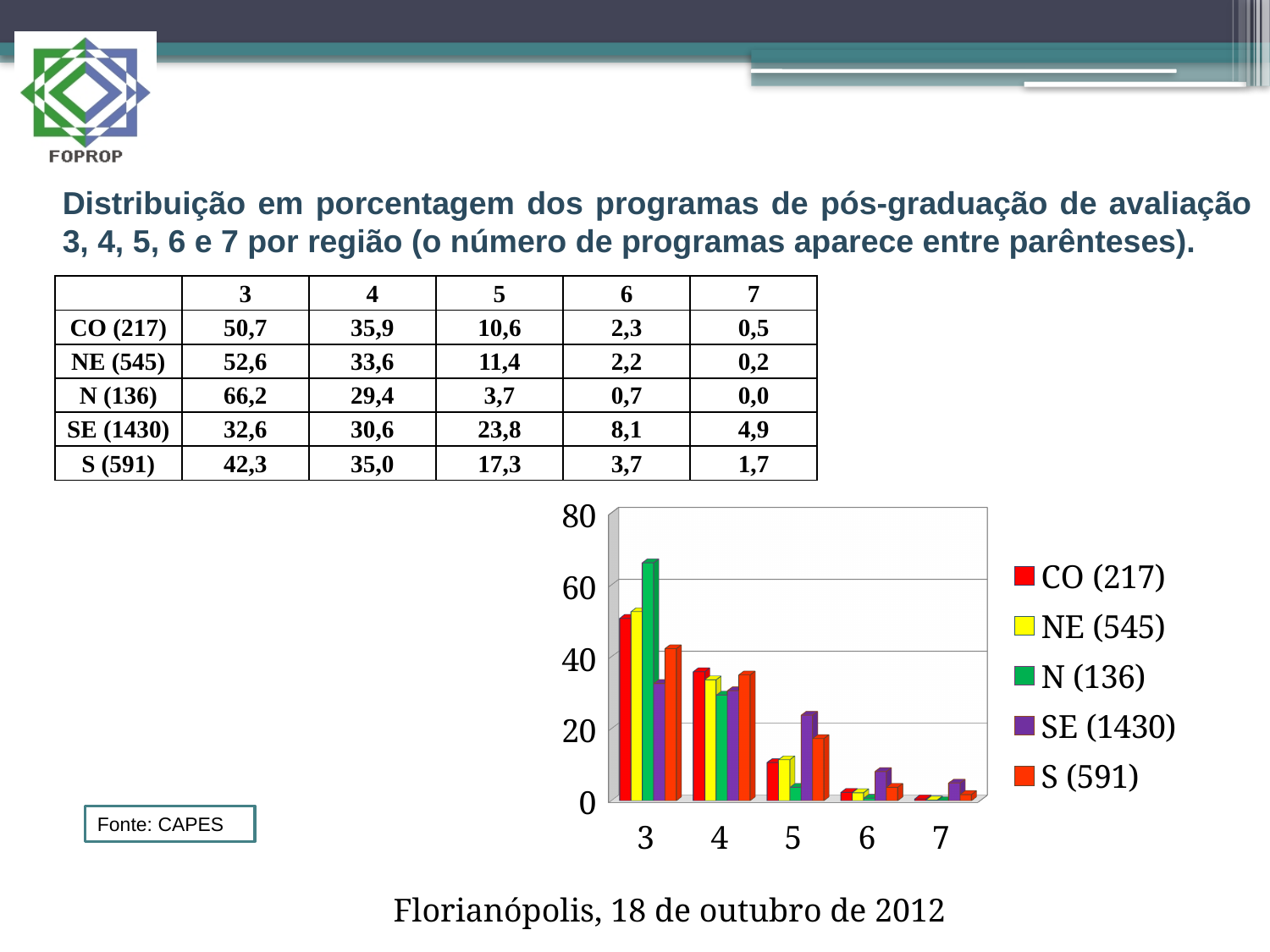
Which region has the highest value for category 3? N (136) What is the value for SE (1430) in category 5, as printed in the table on the slide? 23,8 What kind of chart is shown on the slide? bar chart Is the value for N (136) in category 3 greater or less than 60? greater Is the value for SE (1430) in category 5 greater or less than 20? greater Which region has the lowest value for category 3? SE (1430) Is the value for S (591) in category 3 greater or less than 40? greater Do the values for SE (1430) rise or fall from category 3 to category 7? fall How many series does the chart legend list? 5 Which region has the highest value for category 5? SE (1430) How many categories are shown along the x axis of the chart? 5 Which is larger for category 4: the value for CO (217) or the value for N (136)? CO (217)